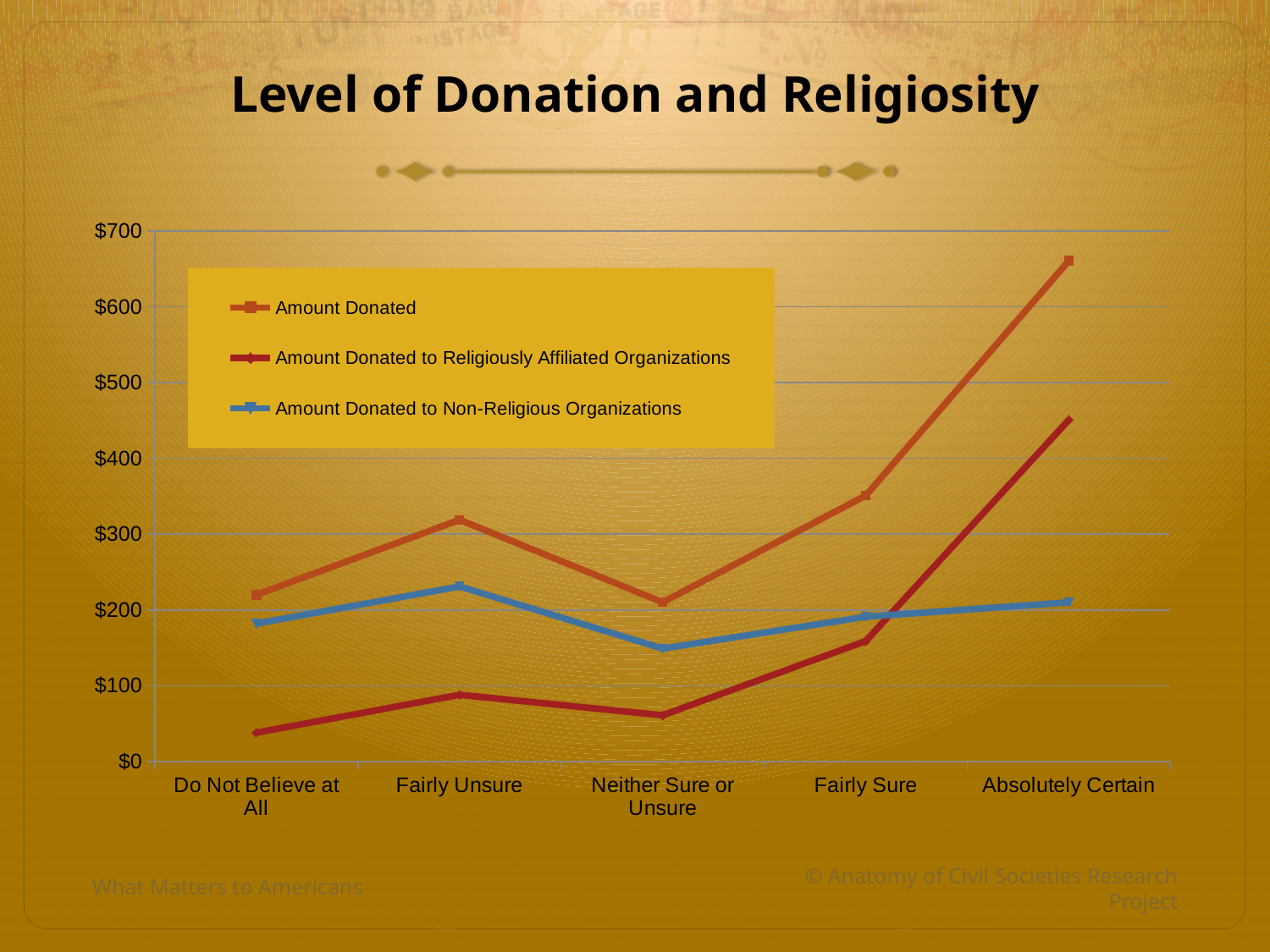
How many series does the legend list? 3 Is the value of Amount Donated for Absolutely Certain greater or less than $600? greater For which category is Amount Donated highest? Absolutely Certain For Absolutely Certain, which is larger: Amount Donated to Religiously Affiliated Organizations or Amount Donated to Non-Religious Organizations? Amount Donated to Religiously Affiliated Organizations What is the title of the chart? Level of Donation and Religiosity What kind of chart is shown on the slide? line chart For which category is Amount Donated to Non-Religious Organizations lowest? Neither Sure or Unsure For which category is Amount Donated to Religiously Affiliated Organizations lowest? Do Not Believe at All Is the value of Amount Donated to Religiously Affiliated Organizations for Do Not Believe at All greater or less than $100? less For Do Not Believe at All, which is larger: Amount Donated to Non-Religious Organizations or Amount Donated to Religiously Affiliated Organizations? Amount Donated to Non-Religious Organizations Is the value of Amount Donated for Fairly Sure greater or less than $300? greater How many categories are shown along the x axis? 5